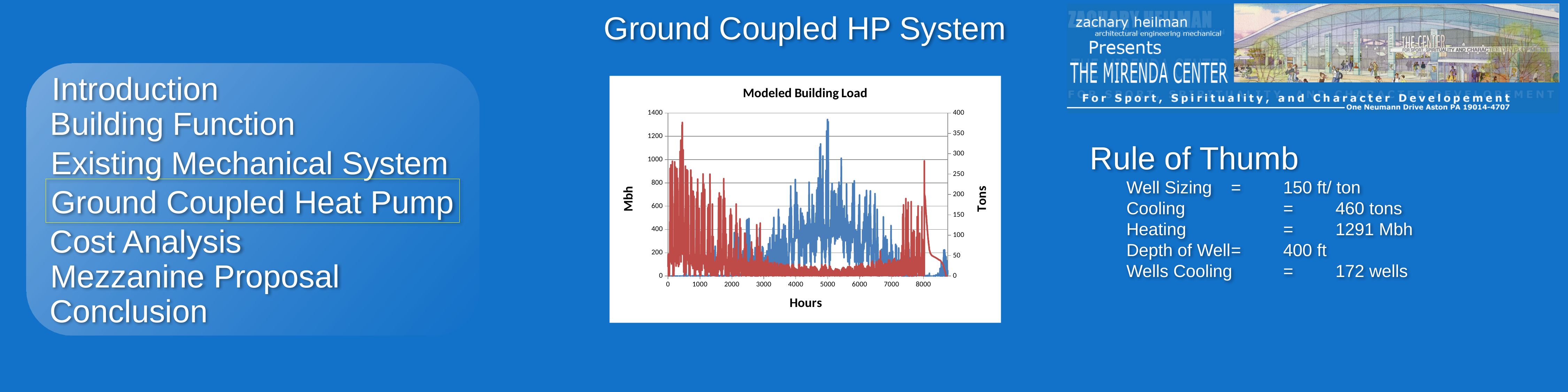
What kind of chart is the Modeled Building Load chart? line chart What is the highest tick value shown on the left (Mbh) axis of the Modeled Building Load chart? 1400 In the Modeled Building Load chart, does the red (Mbh) series generally rise or fall between hour 0 and hour 3000? fall In the Modeled Building Load chart, which series reaches its peak around hour 5000, the red (Mbh) series or the blue (Tons) series? the blue (Tons) series What is the label of the left vertical axis of the Modeled Building Load chart? Mbh What is the highest tick value shown on the right (Tons) axis of the Modeled Building Load chart? 400 In the Modeled Building Load chart, is the peak of the red (Mbh) series greater or less than 1200? greater How many data series are plotted in the Modeled Building Load chart? 2 In the Modeled Building Load chart, is the peak of the blue (Tons) series greater or less than 350? greater